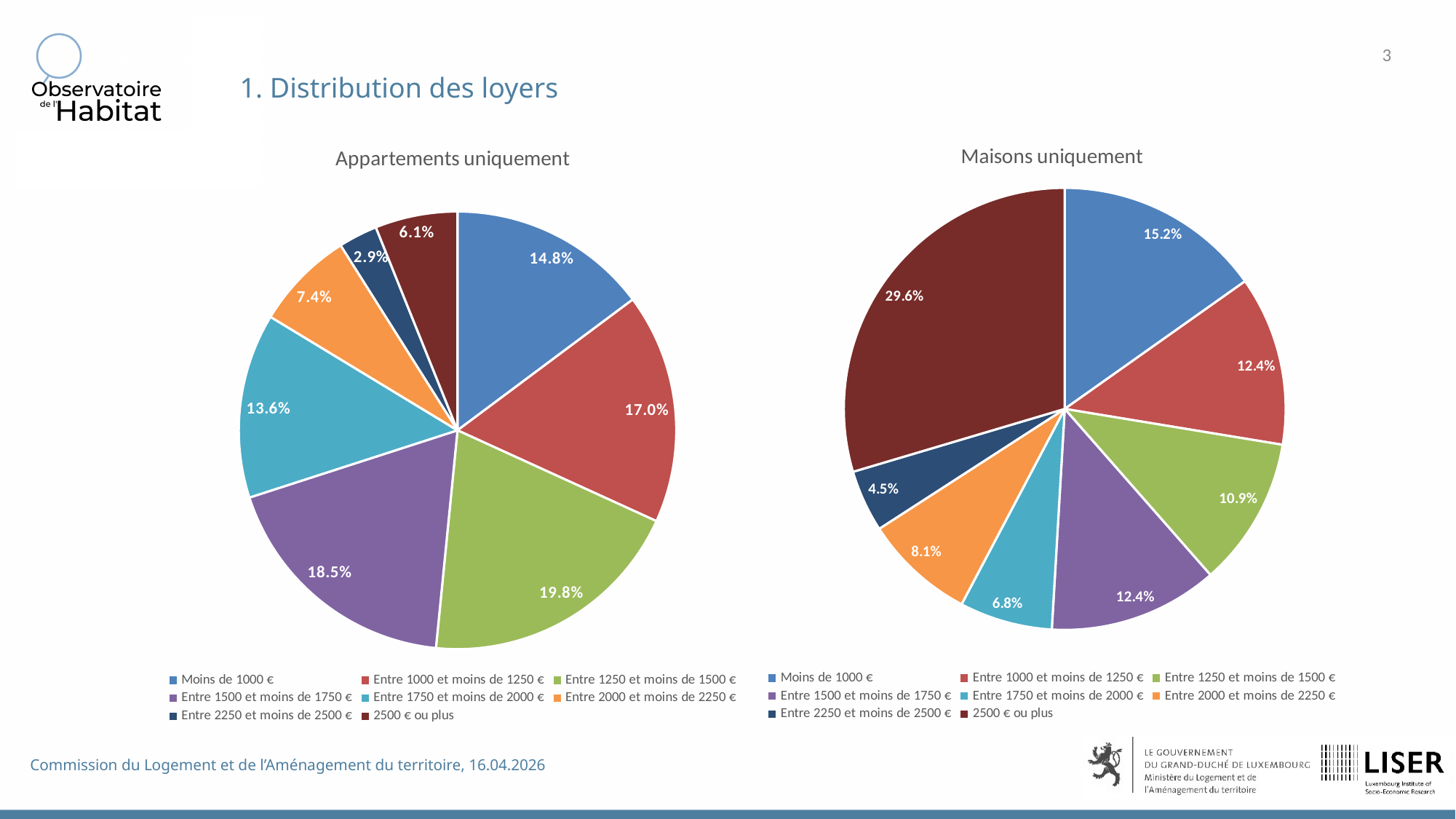
What type of chart is used for 'Maisons uniquement'? Pie chart In the 'Appartements uniquement' chart, which category has the largest slice? Entre 1250 et moins de 1500 € How many categories does the 'Appartements uniquement' pie chart have? 8 What is the title of the chart on the left of the slide? Appartements uniquement In the 'Appartements uniquement' chart, what share is labelled for 'Entre 2250 et moins de 2500 €'? 2.9% What is the difference between the '2500 € ou plus' share in the 'Maisons uniquement' chart and the '2500 € ou plus' share in the 'Appartements uniquement' chart? 23.5 percentage points In the 'Maisons uniquement' chart, which is larger: 'Moins de 1000 €' or 'Entre 1250 et moins de 1500 €'? Moins de 1000 € In the 'Maisons uniquement' chart, which category has the smallest slice? Entre 2250 et moins de 2500 € In the 'Maisons uniquement' chart, what share is labelled for '2500 € ou plus'? 29.6% In the 'Appartements uniquement' chart, what share is labelled for 'Entre 1250 et moins de 1500 €'? 19.8% In the 'Appartements uniquement' chart, which category has the smallest slice? Entre 2250 et moins de 2500 € In the 'Maisons uniquement' chart, what share is labelled for 'Entre 1750 et moins de 2000 €'? 6.8%